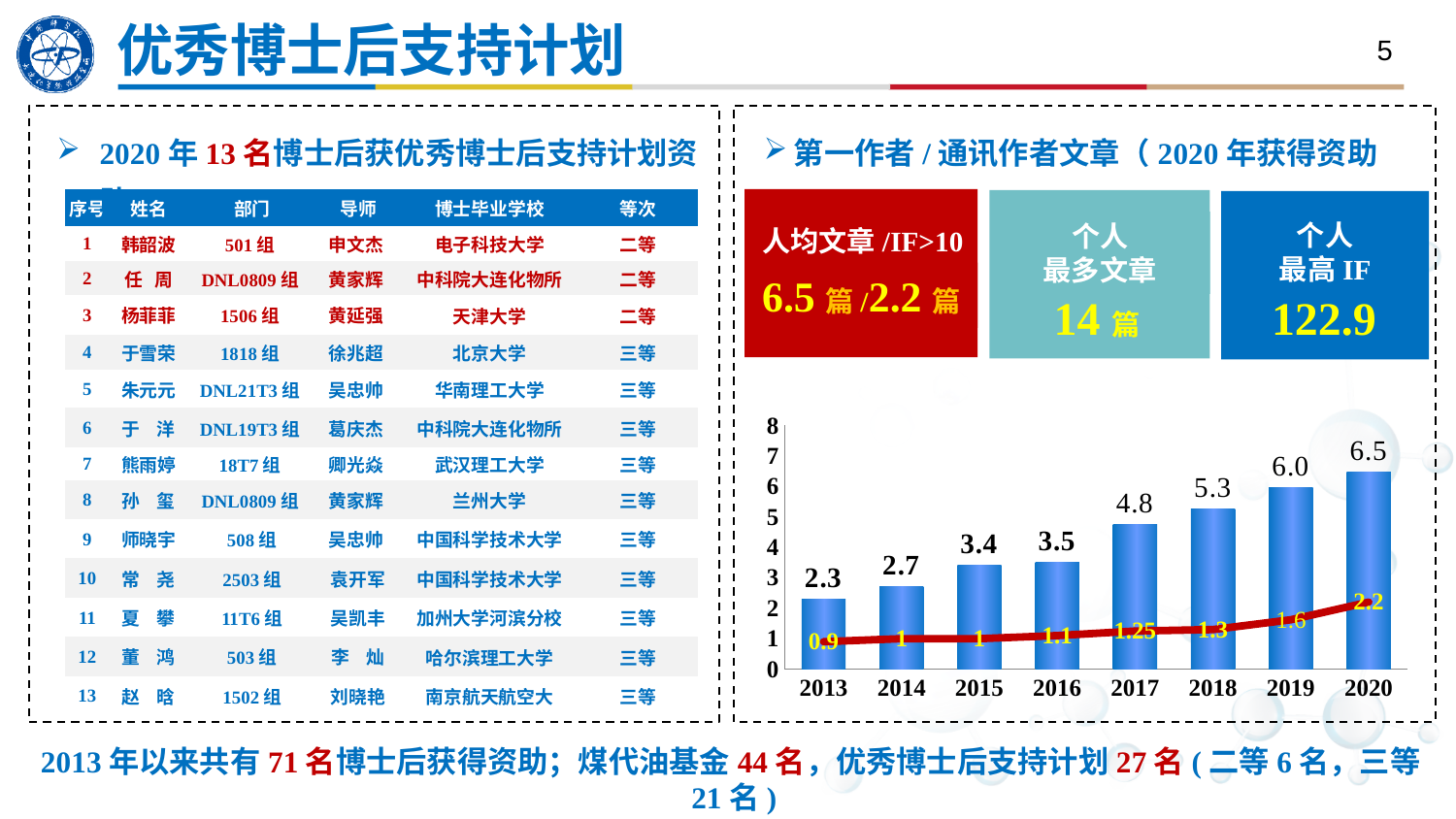
Do the bar values rise or fall from 2013 to 2020? rise Which year has the highest bar in the chart? 2020 What is the difference between the bar values for 2020 and 2013? 4.2 How many years are shown on the x axis of the chart? 8 What is the difference between the bar values for 2017 and 2016? 1.3 What is the value of the bar for 2020 in the chart? 6.5 Which year has the lowest bar in the chart? 2013 What kind of chart is shown on the slide? bar chart with a line Which is larger, the bar value for 2018 or the bar value for 2019? 2019 What is the value of the bar for 2013 in the chart? 2.3 What is the value of the line data point for 2020 in the chart? 2.2 What is the value of the line data point for 2017 in the chart? 1.25